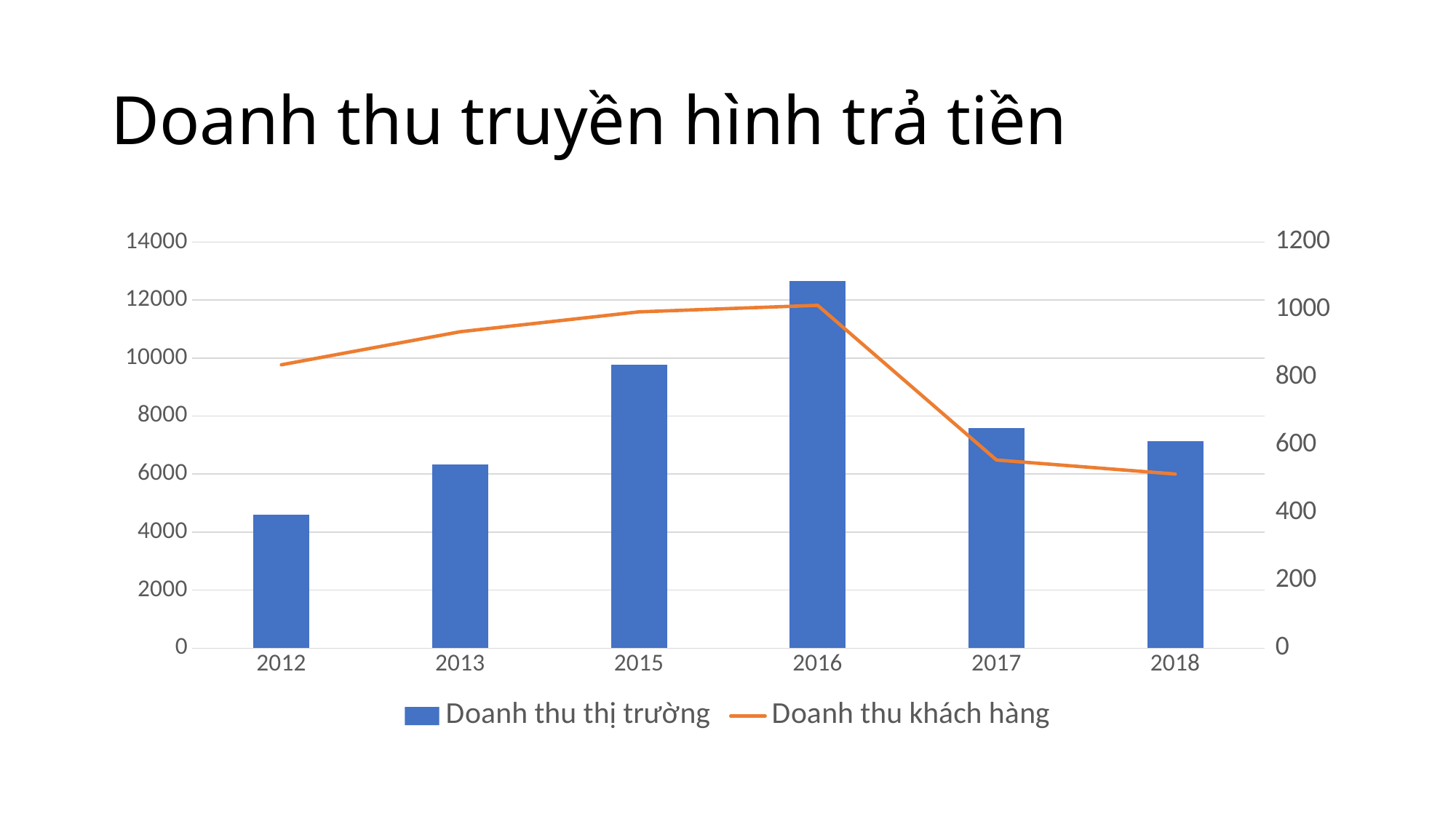
What kind of chart is shown on the slide? A combined bar and line chart How many years are shown on the x axis? 6 Is the Doanh thu thị trường bar higher in 2015 or in 2013? 2015 Is the Doanh thu thị trường value for 2012 greater or less than 6000? less On the right axis, is the Doanh thu khách hàng value for 2018 greater or less than 600? less Which year has the lowest bar for Doanh thu thị trường? 2012 How many series does the legend list? 2 Do the Doanh thu thị trường bars rise or fall from 2012 to 2016? rise Which year has the highest bar for Doanh thu thị trường? 2016 What is the title of the slide? Doanh thu truyền hình trả tiền Is the Doanh thu thị trường value for 2016 greater or less than 12000? greater Does the Doanh thu khách hàng line rise or fall from 2016 to 2018? fall